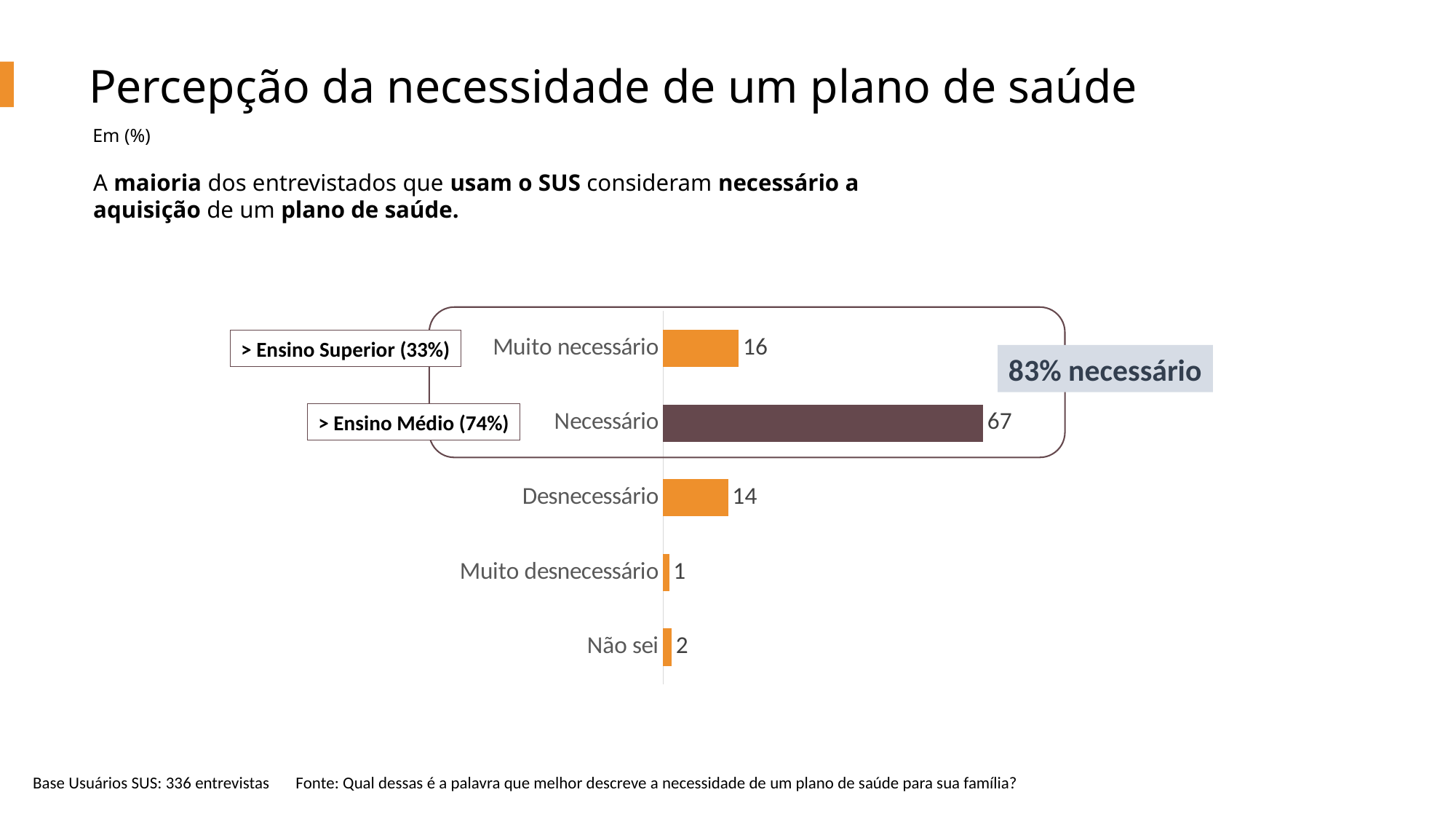
What colour is the bar for "Necessário"? Dark brown How many categories are shown in the chart? 5 Which category has the highest value? Necessário What is the difference between the values for "Necessário" and "Muito necessário"? 51 What is the combined value of "Muito necessário" and "Necessário" as highlighted on the slide? 83% necessário Which category has the lowest value? Muito desnecessário Which is larger, the value for "Muito necessário" or the value for "Desnecessário"? Muito necessário What is the value for "Necessário"? 67 What is the value for "Não sei"? 2 What is the value for "Muito necessário"? 16 What is the value for "Desnecessário"? 14 What kind of chart is shown on the slide? Bar chart